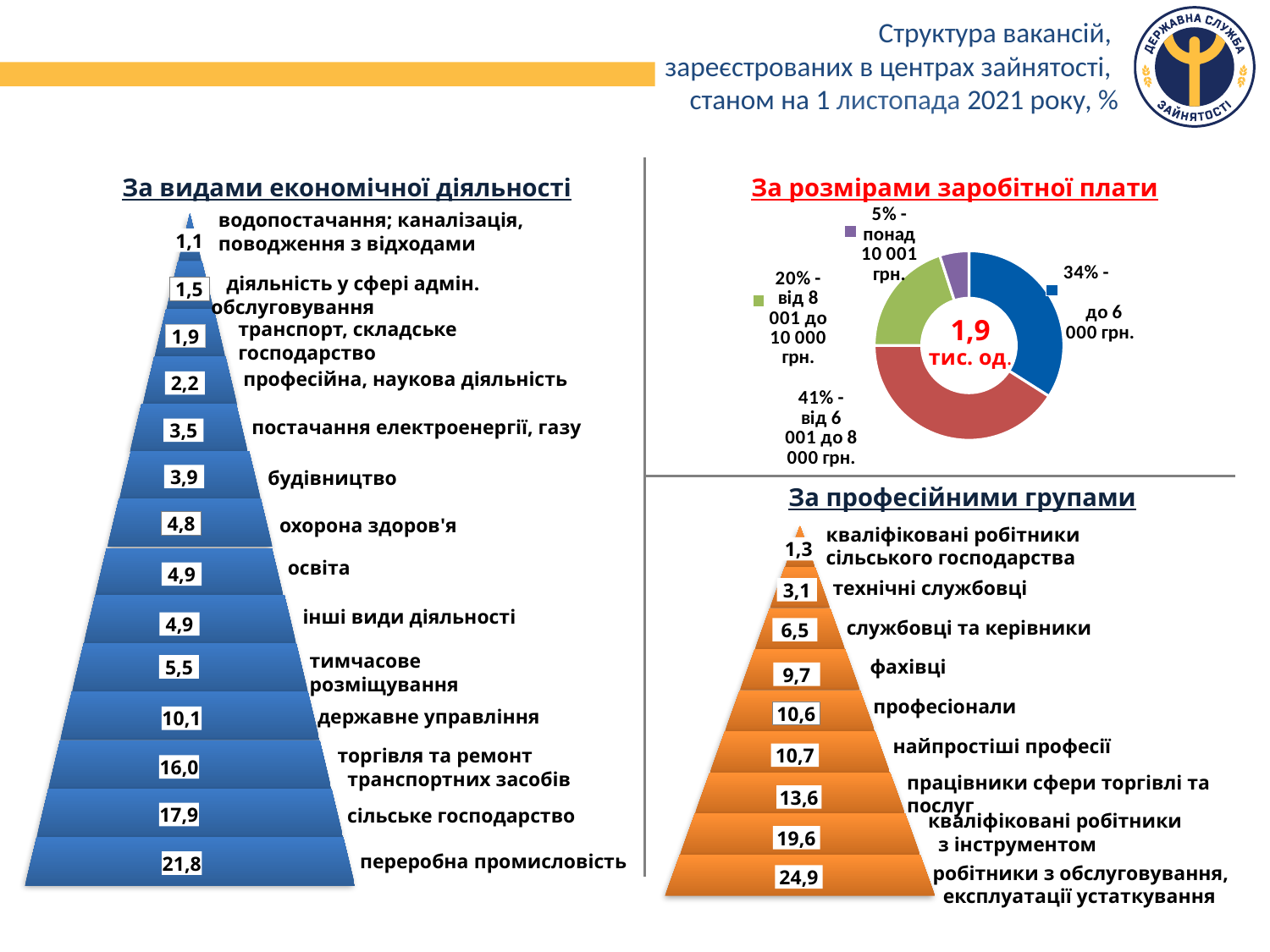
On the chart 'За професійними групами', which is larger: кваліфіковані робітники з інструментом or працівники сфери торгівлі та послуг? кваліфіковані робітники з інструментом On the chart 'За розмірами заробітної плати', which wage range has the smallest share? понад 10 001 грн. On the chart 'За видами економічної діяльності', what is the difference between сільське господарство and торгівля та ремонт транспортних засобів? 1,9 What kind of chart is 'За розмірами заробітної плати'? pie (donut) chart On the chart 'За професійними групами', which category has the highest value? робітники з обслуговування, експлуатації устаткування On the chart 'За видами економічної діяльності', how many categories are shown? 14 On the chart 'За розмірами заробітної плати', what total number is shown in the centre of the donut? 1,9 тис. од. On the chart 'За розмірами заробітної плати', what share of vacancies have a wage від 6 001 до 8 000 грн.? 41% On the chart 'За видами економічної діяльності', which category has the lowest value? водопостачання; каналізація, поводження з відходами On the chart 'За видами економічної діяльності', what is the value for державне управління? 10,1 On the chart 'За професійними групами', what is the value for фахівці? 9,7 On the chart 'За видами економічної діяльності', what is the value for переробна промисловість? 21,8